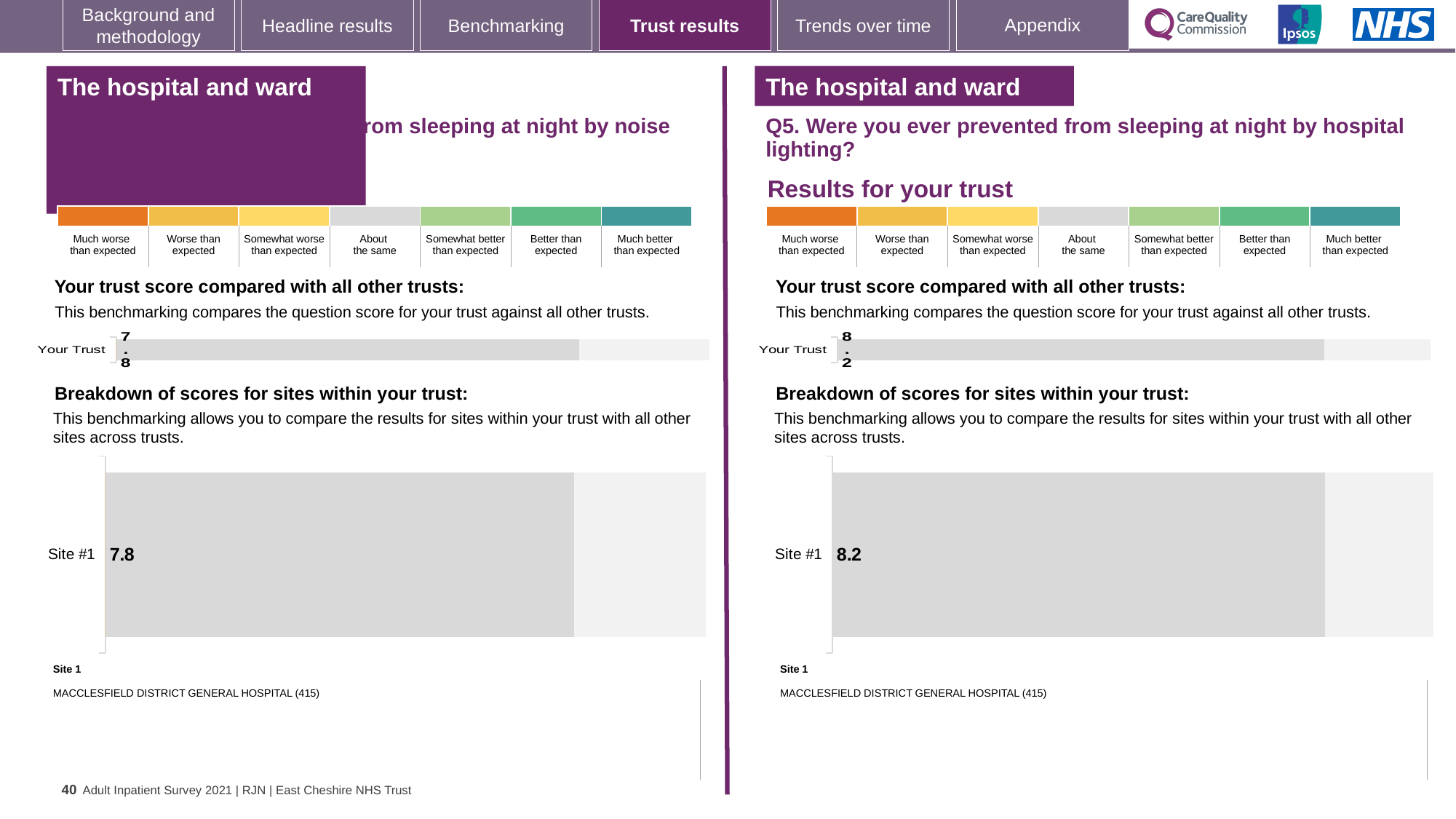
On the left half of the slide (sleeping at night by noise), what is the score shown for Your Trust? 7.8 What kind of chart is used to show the Site #1 score on the right half of the slide? Bar chart On the right half of the slide (Q5, hospital lighting), what is the score shown for Your Trust? 8.2 How many categories does the colour scale above the charts on the right half of the slide contain? 7 What is the difference between the Site #1 score on the right half (Q5) and the Site #1 score on the left half of the slide? 0.4 In the left 'Breakdown of scores for sites within your trust' chart, what is the value for Site #1? 7.8 Which hospital is listed as Site 1 on the right half of the slide? MACCLESFIELD DISTRICT GENERAL HOSPITAL (415) In the right 'Breakdown of scores for sites within your trust' chart (Q5), what is the value for Site #1? 8.2 How many sites are shown in the left 'Breakdown of scores for sites within your trust' chart? 1 Which is larger: the Your Trust score on the left half of the slide or the Your Trust score on the right half (Q5)? Right half (Q5), 8.2 How many sites are shown in the right 'Breakdown of scores for sites within your trust' chart (Q5)? 1